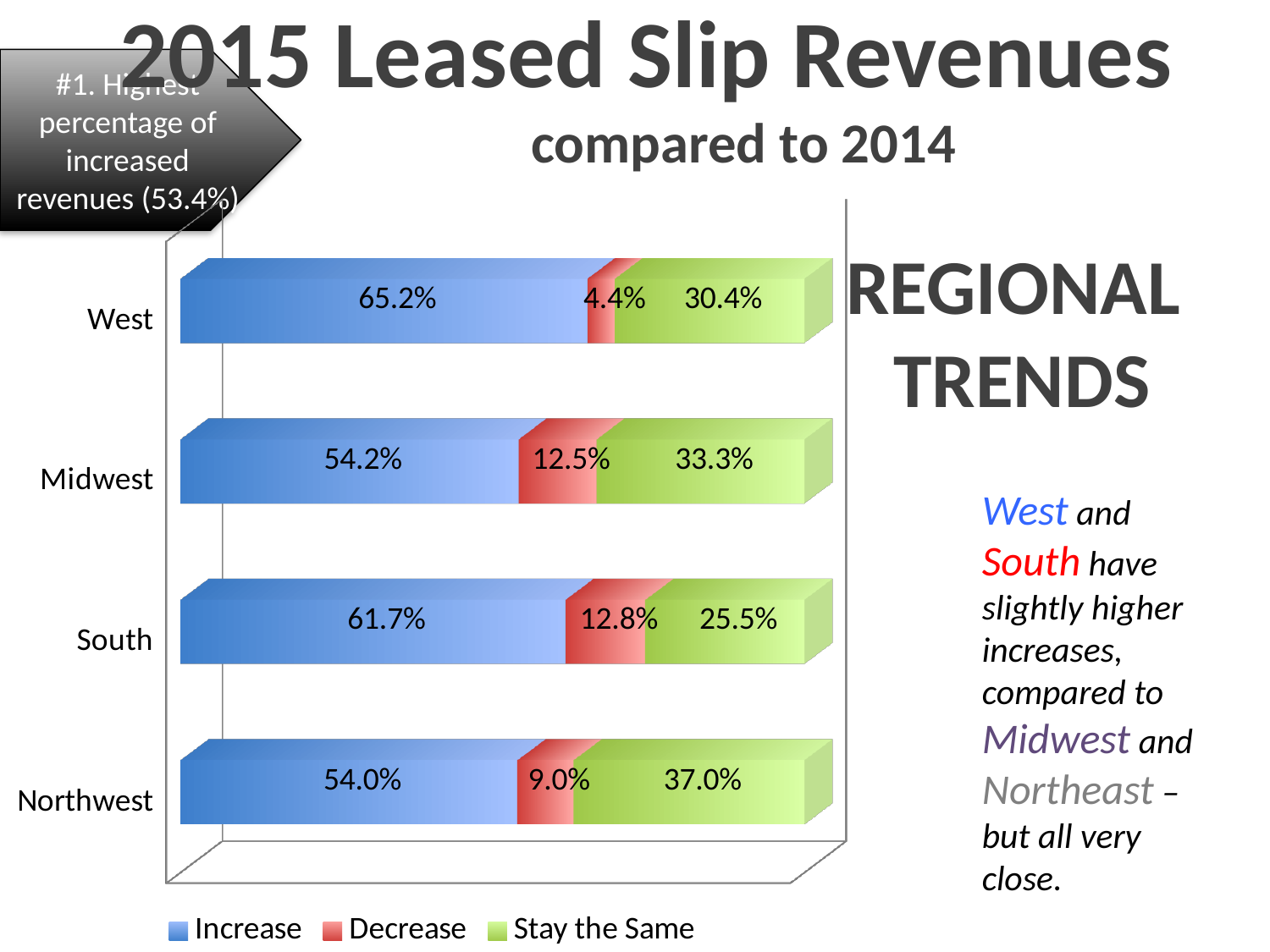
How many series does the legend list? 3 What percentage of the West region reported an Increase in leased slip revenues? 65.2% How many regions are shown in the chart? 4 Which region has the lowest percentage for Decrease? West What percentage of the South region reported an Increase? 61.7% Which colour represents the Decrease series in the chart? Red What percentage of the Midwest region reported a Decrease? 12.5% What percentage of the Northwest region reported Stay the Same? 37.0% Which is larger, the Stay the Same percentage for Northwest or for South? Northwest Which region has the highest percentage for Increase? West What kind of chart is shown on the slide? Stacked bar chart What is the difference between the Increase percentages for West and Midwest? 11.0%